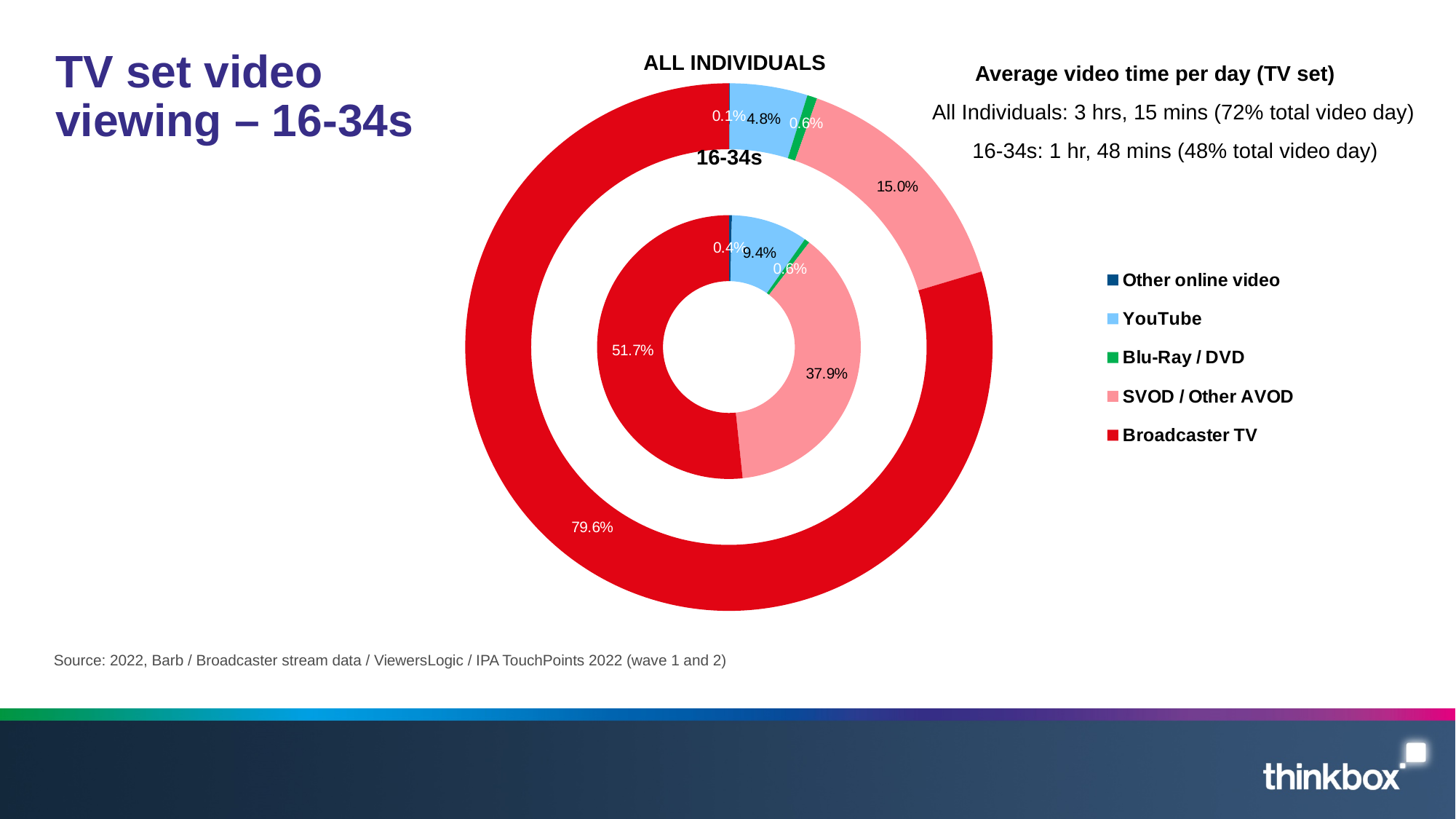
Which is larger: the SVOD / Other AVOD share for 16-34s or for ALL INDIVIDUALS? 16-34s Which category has the smallest share in the ALL INDIVIDUALS ring? Other online video In the ALL INDIVIDUALS ring, what share is Broadcaster TV? 79.6% Which category has the largest share in the 16-34s ring? Broadcaster TV How many categories does the legend list? 5 In the 16-34s ring, what share is YouTube? 9.4% What is the difference between the Broadcaster TV share for ALL INDIVIDUALS and for 16-34s? 27.9 percentage points In the ALL INDIVIDUALS ring, what share is YouTube? 4.8% In the ALL INDIVIDUALS ring, what share is SVOD / Other AVOD? 15.0% In the 16-34s ring, what share is SVOD / Other AVOD? 37.9% What kind of chart is shown on the slide? Doughnut chart In the 16-34s ring, what share is Broadcaster TV? 51.7%